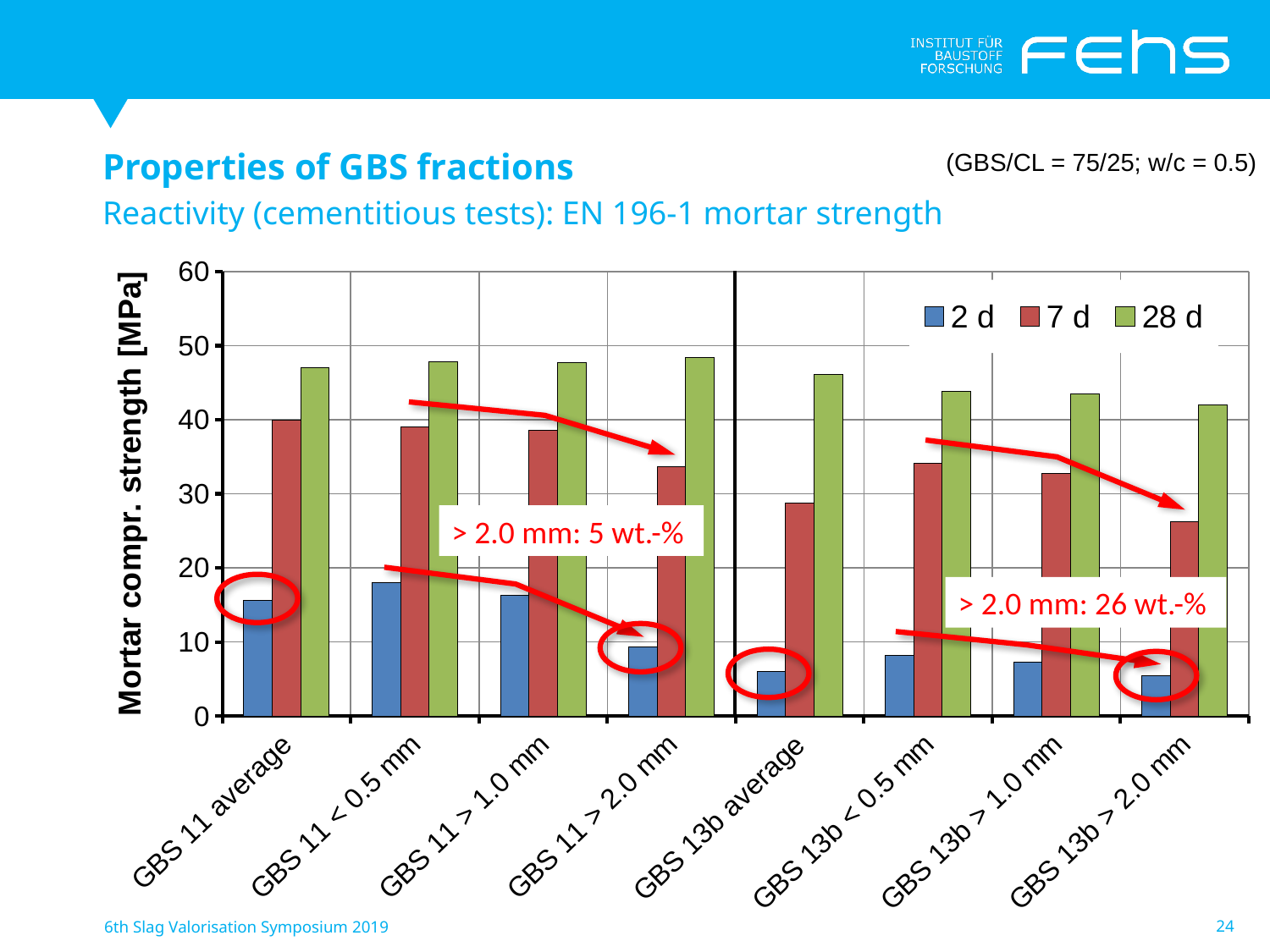
Is the 7 d value for GBS 11 average greater or less than 30? greater How many series does the legend list? 3 Which has the larger 7 d value: GBS 11 > 2.0 mm or GBS 13b > 2.0 mm? GBS 11 > 2.0 mm How many categories are shown on the x axis? 8 Is the 28 d value for GBS 13b > 2.0 mm greater or less than 40? greater Which category has the highest 2 d mortar compressive strength? GBS 11 < 0.5 mm What are the three legend entries of the chart? 2 d, 7 d, 28 d What kind of chart is shown on the slide? bar chart Do the 7 d values rise or fall going from GBS 13b < 0.5 mm to GBS 13b > 2.0 mm? fall Is the 2 d value for GBS 13b average greater or less than 10? less What is the label of the y axis? Mortar compr. strength [MPa] Which category has the lowest 7 d mortar compressive strength? GBS 13b > 2.0 mm